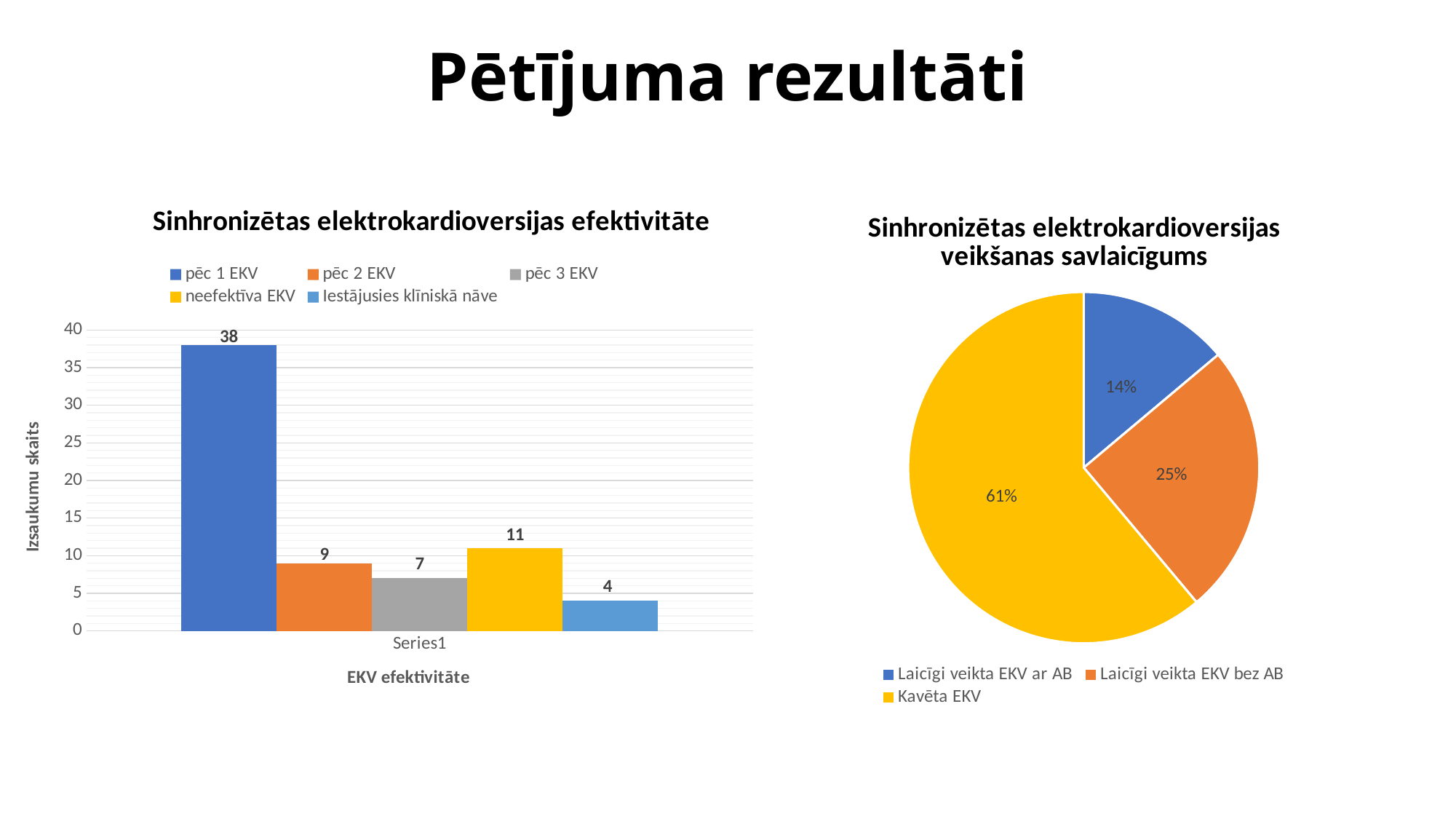
In the chart 'Sinhronizētas elektrokardioversijas efektivitāte', which is larger: 'pēc 3 EKV' or 'neefektīva EKV'? neefektīva EKV How many series does the legend of the chart 'Sinhronizētas elektrokardioversijas efektivitāte' list? 5 In the chart 'Sinhronizētas elektrokardioversijas veikšanas savlaicīgums', which slice is the largest? Kavēta EKV In the chart 'Sinhronizētas elektrokardioversijas efektivitāte', which series has the lowest value? Iestājusies klīniskā nāve In the chart 'Sinhronizētas elektrokardioversijas efektivitāte', what is the value for 'pēc 1 EKV'? 38 In the chart 'Sinhronizētas elektrokardioversijas veikšanas savlaicīgums', what share does 'Laicīgi veikta EKV ar AB' have? 14% In the chart 'Sinhronizētas elektrokardioversijas efektivitāte', which series has the highest value? pēc 1 EKV In the chart 'Sinhronizētas elektrokardioversijas efektivitāte', what is the value for 'neefektīva EKV'? 11 What kind of chart is 'Sinhronizētas elektrokardioversijas efektivitāte'? bar chart In the chart 'Sinhronizētas elektrokardioversijas efektivitāte', what is the difference between the values for 'pēc 1 EKV' and 'pēc 2 EKV'? 29 In the chart 'Sinhronizētas elektrokardioversijas veikšanas savlaicīgums', what share does 'Kavēta EKV' have? 61% What is the y-axis title of the chart 'Sinhronizētas elektrokardioversijas efektivitāte'? Izsaukumu skaits